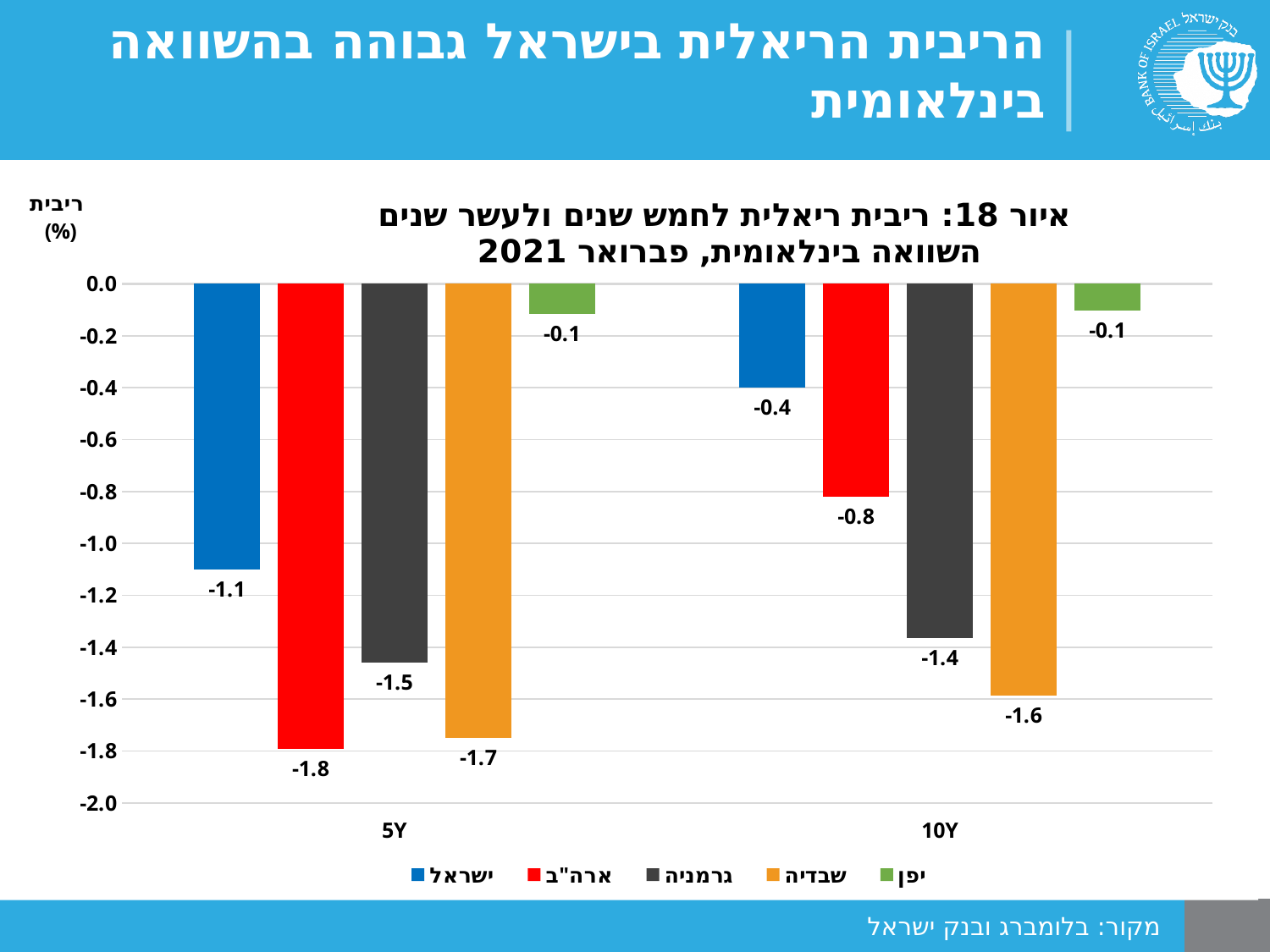
How many categories are shown on the x axis? 2 How many series does the legend list? 5 Which is larger, the 10Y value for ישראל (Israel) or the 10Y value for ארה"ב (USA)? ישראל (Israel), -0.4 Which series has the lowest value at 5Y? ארה"ב (USA), -1.8 What is the value for ארה"ב (USA) at 10Y? -0.8 Which colour represents שבדיה (Sweden) in the chart? Orange What is the value for ישראל (Israel) at 5Y? -1.1 What is the value for שבדיה (Sweden) at 5Y? -1.7 What is the difference between the 5Y and 10Y values for ישראל (Israel)? 0.7 What kind of chart is shown on the slide? Bar chart Which series has the highest value at 10Y? יפן (Japan), -0.1 What is the value for גרמניה (Germany) at 10Y? -1.4